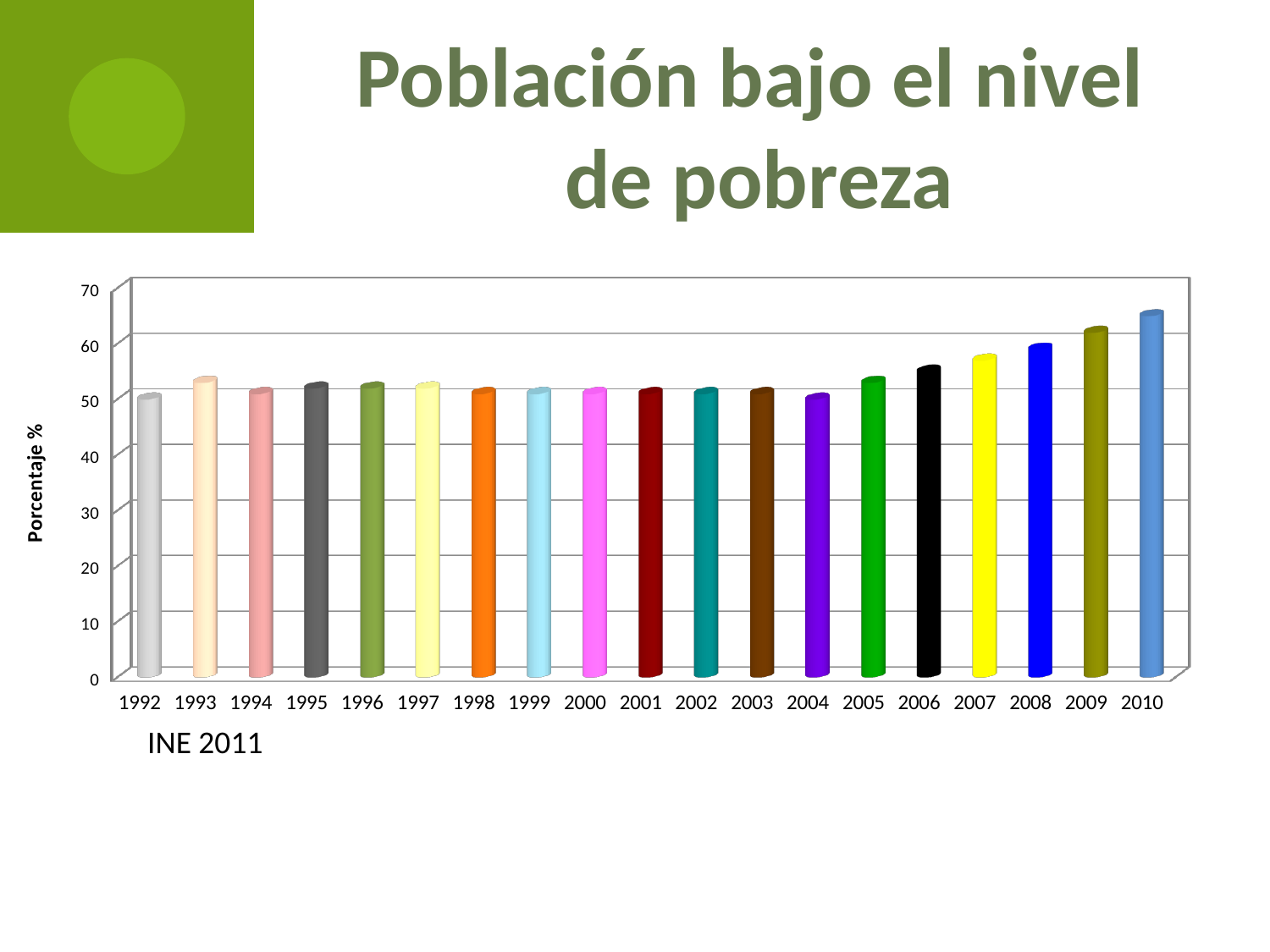
Is the value for 2007 greater or less than 60? less Which is larger, the value for 2009 or the value for 2005? 2009 Which is larger, the value for 2010 or the value for 1992? 2010 Do the values rise or fall from 2004 to 2010? rise What kind of chart is shown on the slide? Bar chart What is the title of the chart on the slide? Población bajo el nivel de pobreza How many years are plotted on the x axis of the chart? 19 What is the label on the vertical axis of the chart? Porcentaje % Is the value for 2010 greater or less than 60? greater Which year has the highest value in the chart? 2010 Is the value for 2006 greater or less than 50? greater